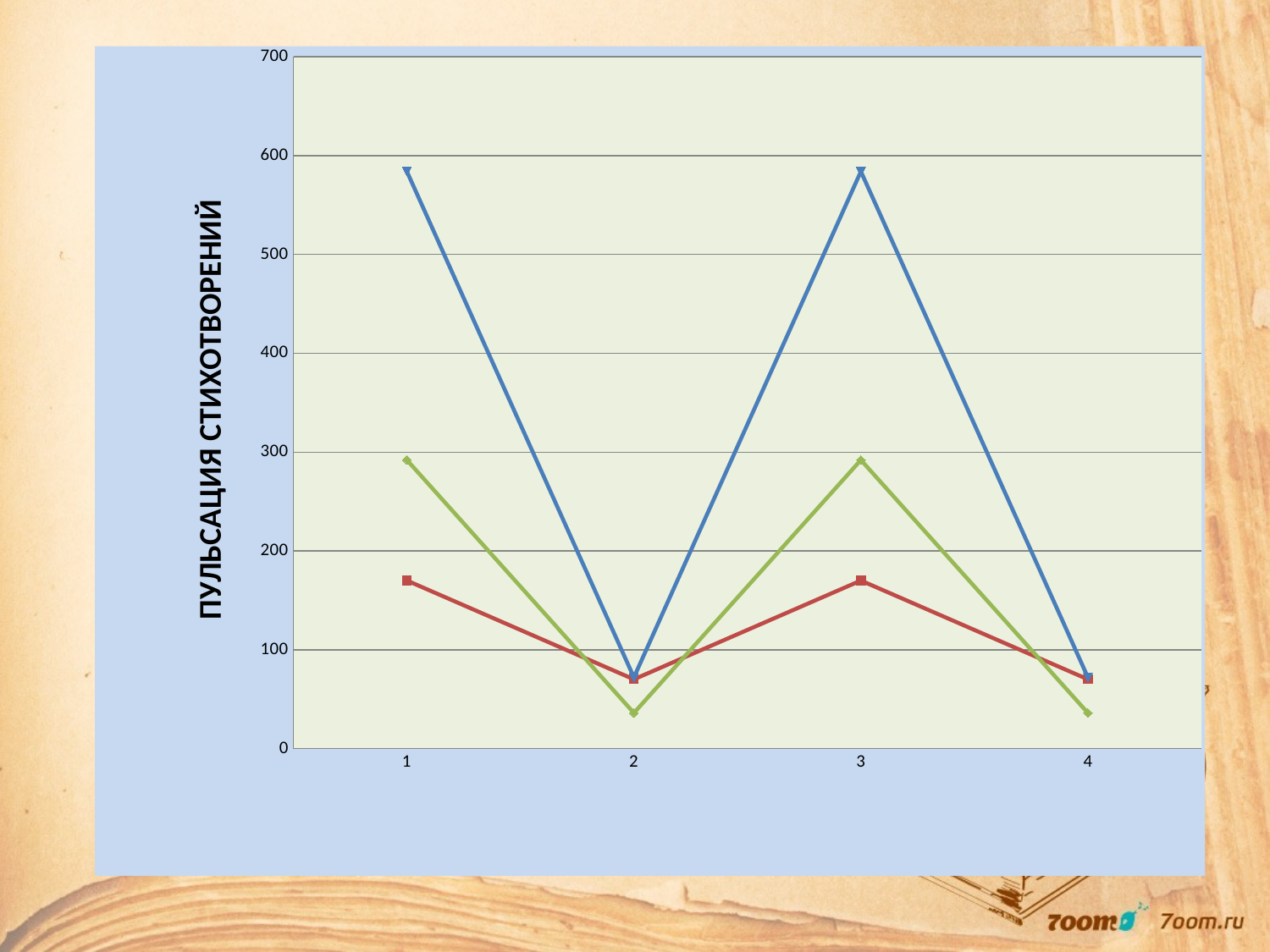
What kind of chart is shown on the slide? line chart Does the blue line rise or fall from category 3 to category 4? fall How many lines are plotted on the chart? 3 At category 2, which line has the larger value, the red line or the green line? red line At category 1, which line has the larger value, the blue line or the red line? blue line What is the title of the vertical axis? ПУЛЬСАЦИЯ СТИХОТВОРЕНИЙ How many categories are shown on the x axis? 4 Is the value of the green line at category 3 greater or less than 200? greater Is the value of the green line at category 2 greater or less than 100? less Is the value of the red line at category 1 greater or less than 200? less